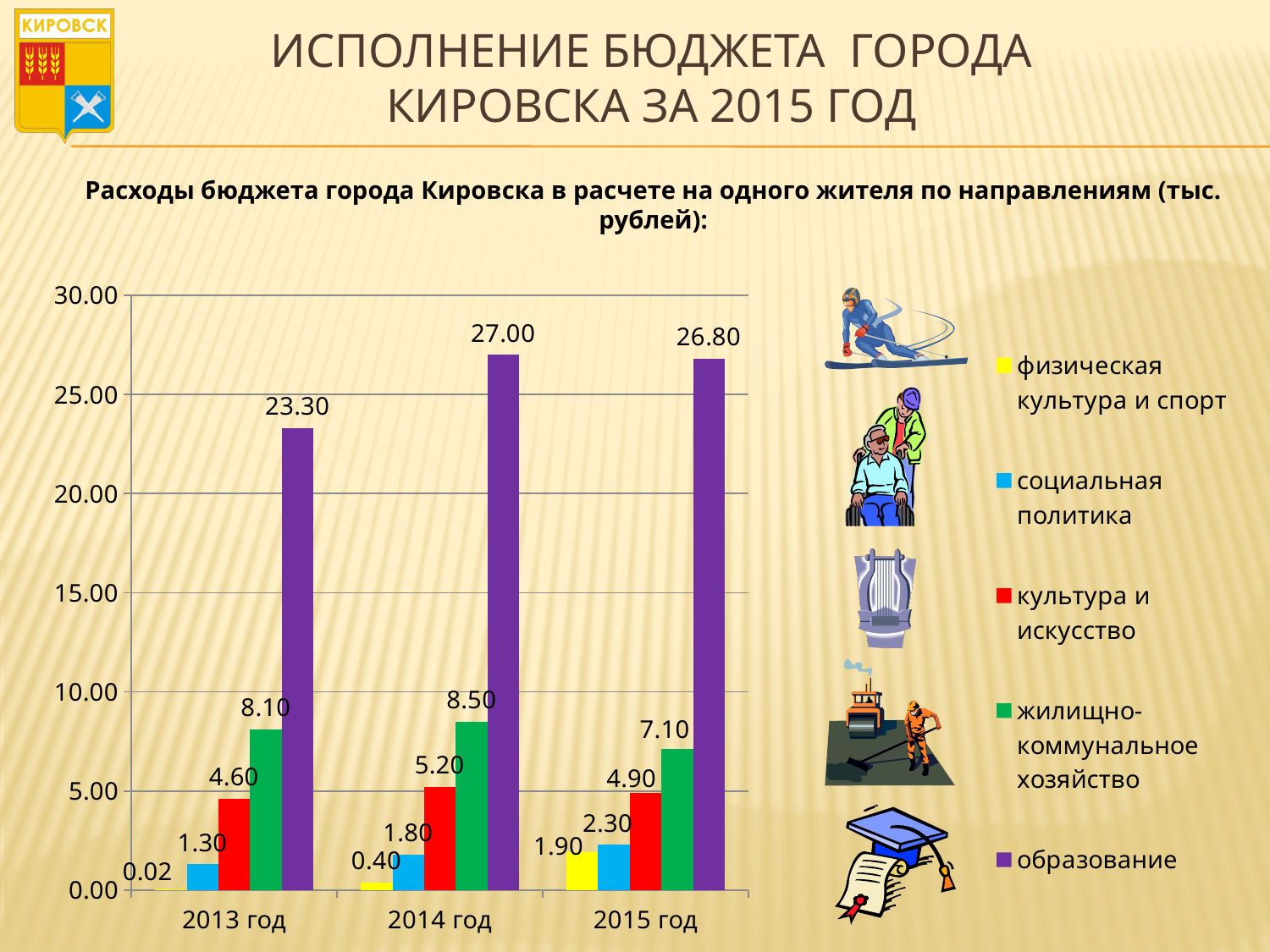
In which year is the value for образование highest? 2014 год In which year is the value for физическая культура и спорт lowest? 2013 год How many year categories are shown on the x axis? 3 What is the difference between the образование values for 2014 год and 2013 год? 3.70 What is the value for образование in 2014 год? 27.00 What is the value for жилищно-коммунальное хозяйство in 2015 год? 7.10 Which is larger: культура и искусство in 2014 год or in 2015 год? 2014 год How many series does the legend list? 5 Which colour represents образование in the legend? purple What is the value for физическая культура и спорт in 2013 год? 0.02 What kind of chart is shown on the slide? bar chart What is the value for социальная политика in 2014 год? 1.80